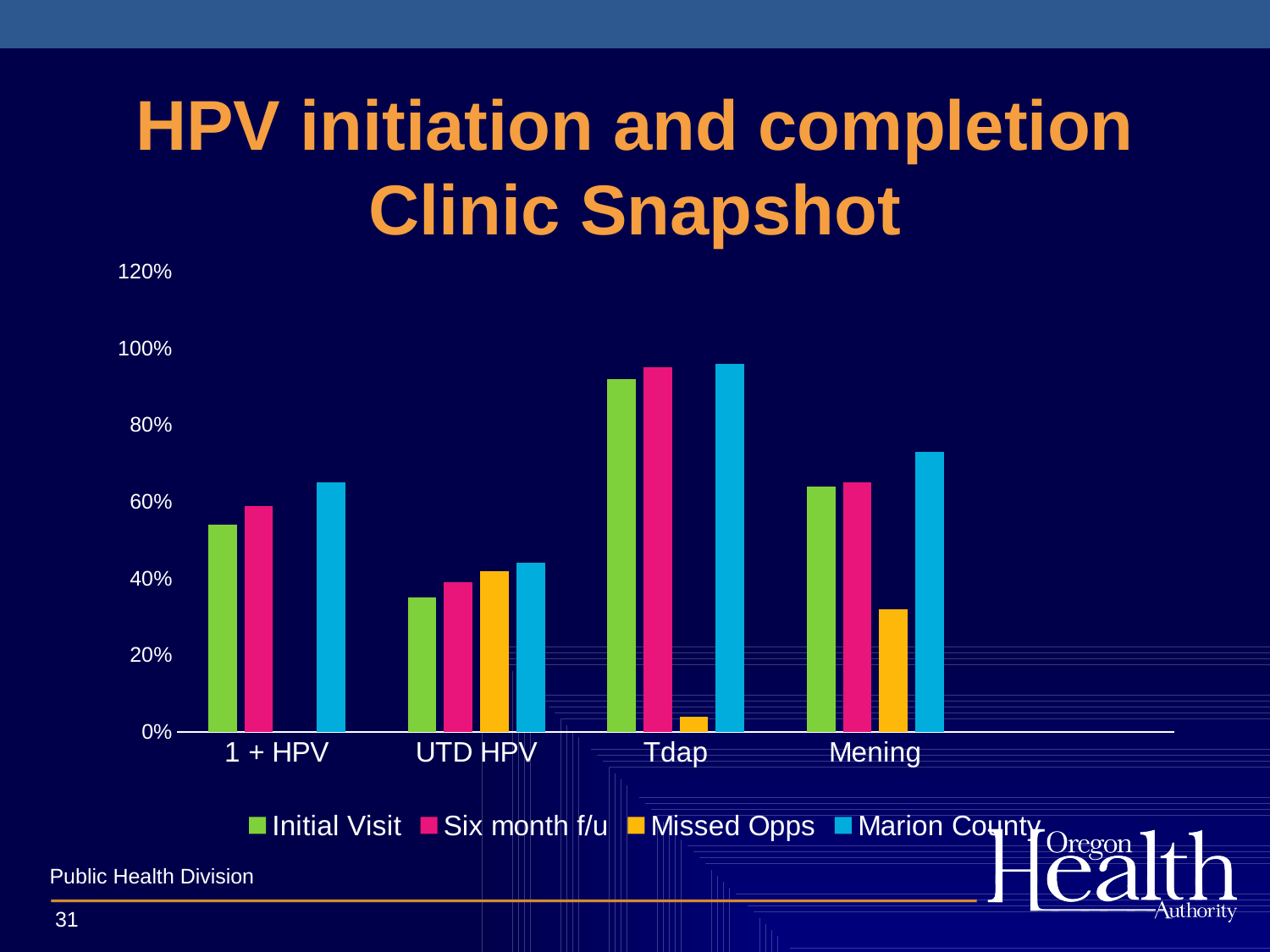
What is the title of the slide containing the chart? HPV initiation and completion Clinic Snapshot Is the Initial Visit value for UTD HPV greater or less than 40%? less Which is larger, the Marion County value for 1 + HPV or for UTD HPV? 1 + HPV Which category has the lowest Initial Visit value? UTD HPV Is the Marion County value for Mening greater or less than 60%? greater Is the Missed Opps value for Tdap greater or less than 20%? less Which category has the highest Marion County value? Tdap Which is larger, the Missed Opps value for Mening or for Tdap? Mening How many series does the legend list? 4 How many categories are shown on the x axis? 4 What kind of chart is shown on the slide? Bar chart